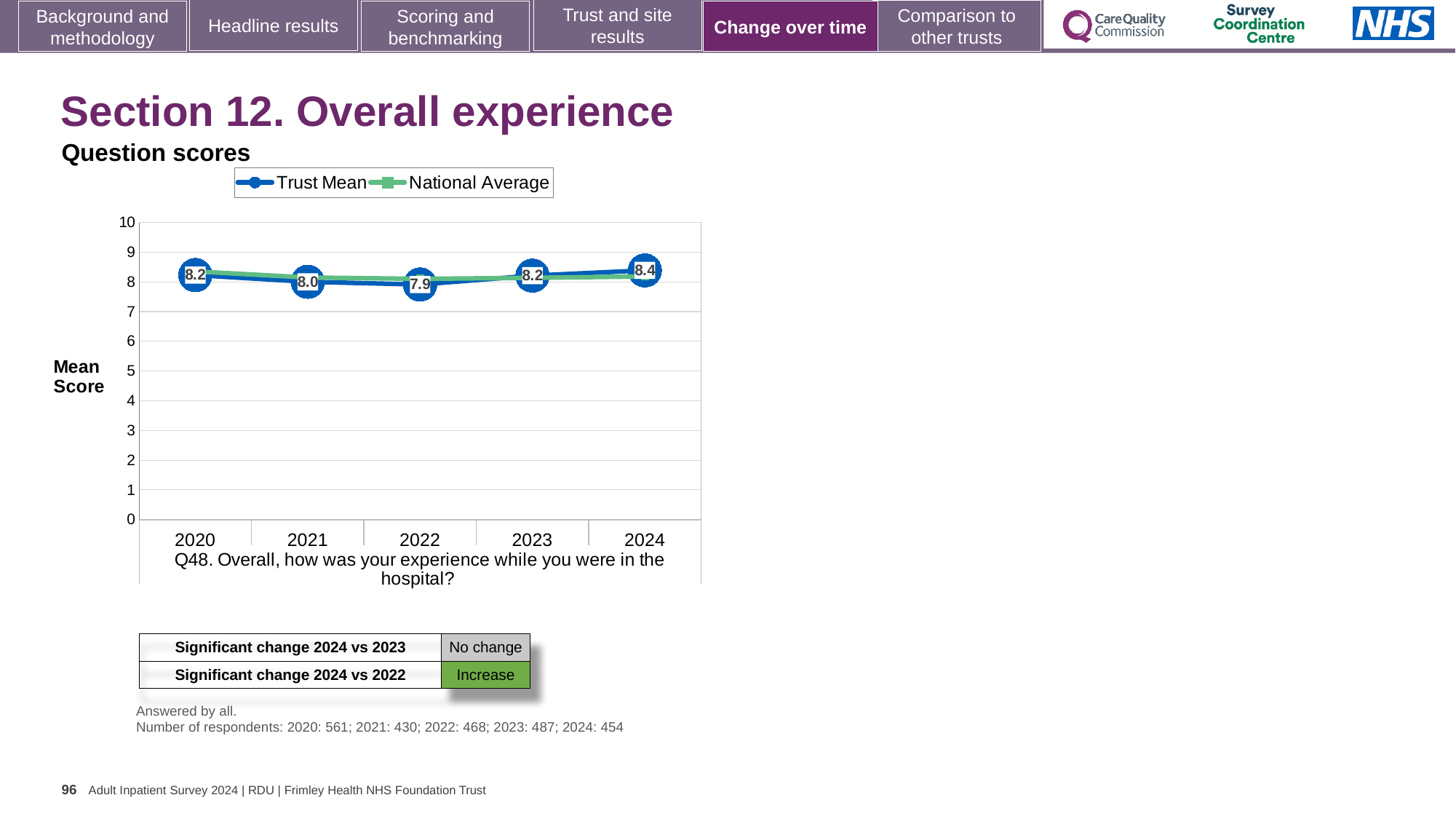
In which year is the Trust Mean score highest? 2024 What is the difference between the Trust Mean score in 2024 and in 2022? 0.5 What is the Trust Mean score for 2024? 8.4 What is the Trust Mean score for 2022? 7.9 Which is larger, the Trust Mean score for 2021 or for 2023? 2023 How many years are plotted on the x axis? 5 What kind of chart is shown on the slide? Line chart Does the Trust Mean score rise or fall from 2022 to 2024? Rise Is the National Average value for 2020 greater or less than 5? greater In which year is the Trust Mean score lowest? 2022 How many series does the legend list? 2 What is the Trust Mean score for 2020? 8.2